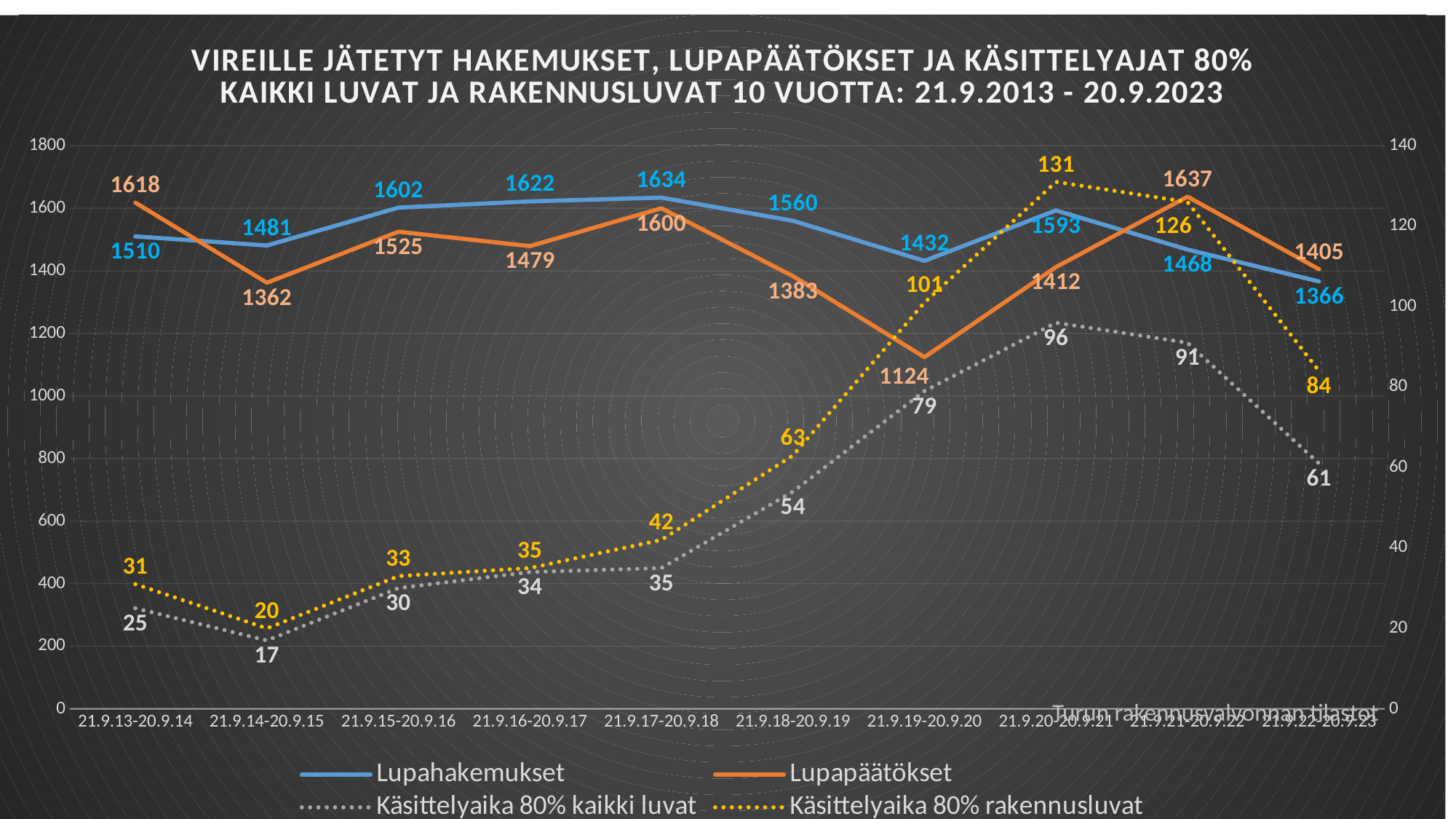
How many periods are shown on the x axis? 10 In which period is Lupapäätökset highest? 21.9.21-20.9.22 How many series does the legend list? 4 In the period 21.9.13-20.9.14, which is larger: Lupahakemukset or Lupapäätökset? Lupapäätökset In which period is Käsittelyaika 80% rakennusluvat highest? 21.9.20-20.9.21 What is the value of Lupahakemukset for the period 21.9.17-20.9.18? 1634 What is the value of Käsittelyaika 80% kaikki luvat for the period 21.9.22-20.9.23? 61 What kind of chart is shown on the slide? Line chart What is the value of Lupapäätökset for the period 21.9.19-20.9.20? 1124 What is the difference between Lupahakemukset and Lupapäätökset in the period 21.9.19-20.9.20? 308 What is the difference between Käsittelyaika 80% rakennusluvat and Käsittelyaika 80% kaikki luvat in the period 21.9.20-20.9.21? 35 In which period is Käsittelyaika 80% kaikki luvat lowest? 21.9.14-20.9.15